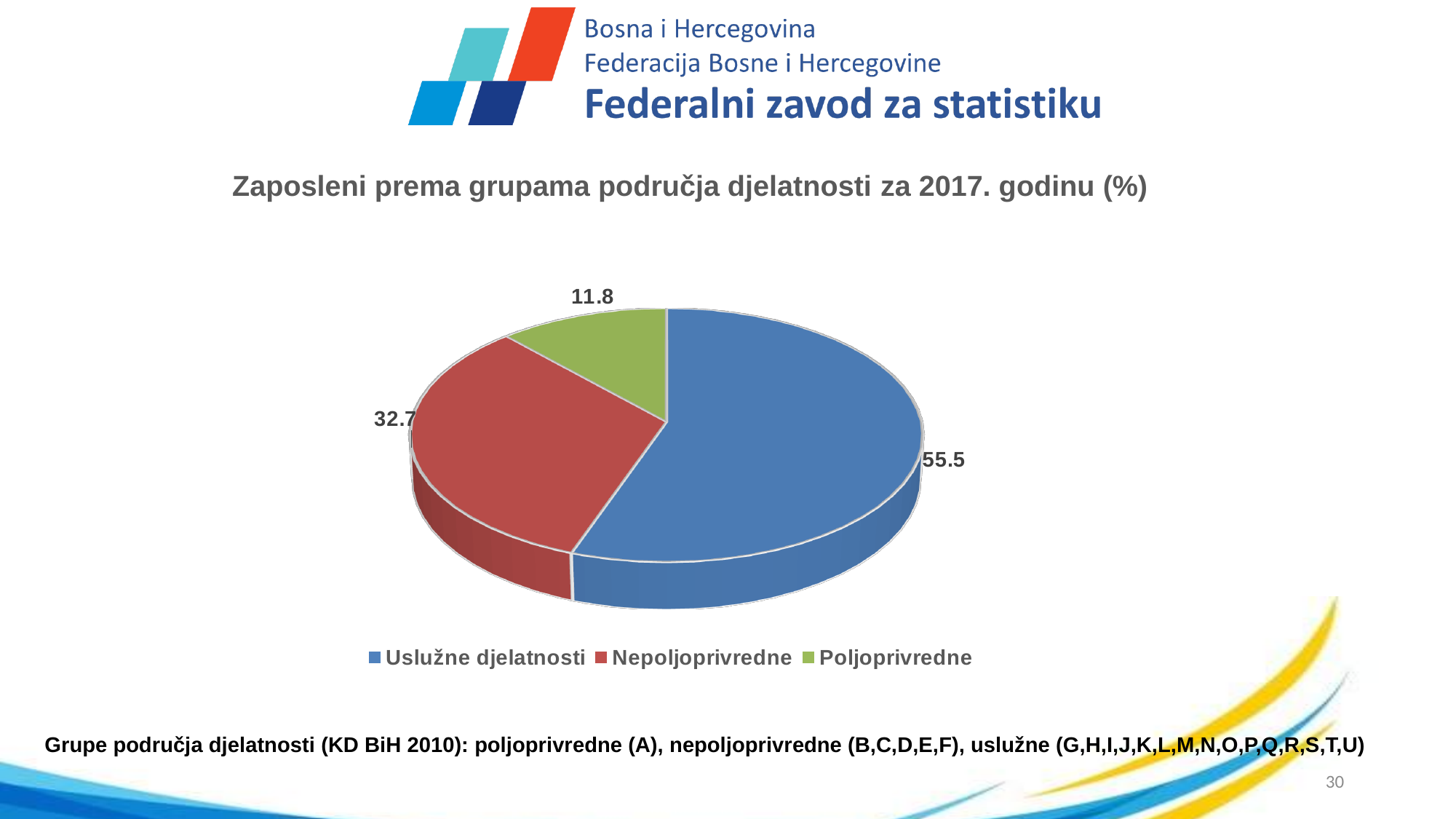
Which category has the smallest share of the pie? Poljoprivredne How many slices does the pie chart have? 3 What is the difference between the values for Uslužne djelatnosti and Nepoljoprivredne? 22.8 Which is larger, the value for Nepoljoprivredne or the value for Poljoprivredne? Nepoljoprivredne What is the value for Nepoljoprivredne? 32.7 Which category has the largest share of the pie? Uslužne djelatnosti What is the value for Poljoprivredne? 11.8 What is the title of the chart? Zaposleni prema grupama područja djelatnosti za 2017. godinu (%) What kind of chart is shown on the slide? pie chart What is the difference between the values for Nepoljoprivredne and Poljoprivredne? 20.9 What is the value for Uslužne djelatnosti? 55.5 What colour is the slice for Poljoprivredne? green